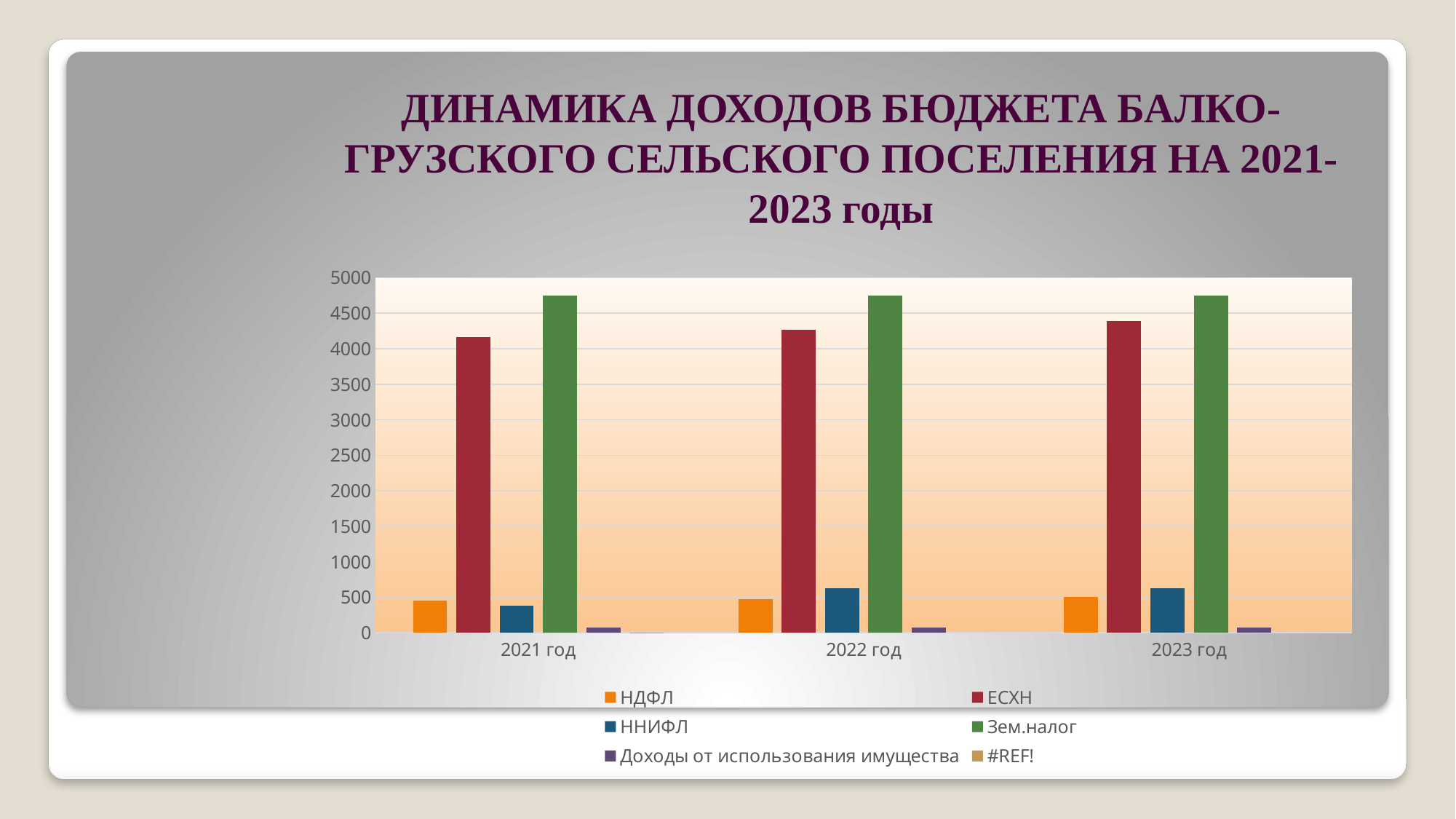
What colour are the bars for Зем.налог? green Which is larger in 2021 год: ЕСХН or Зем.налог? Зем.налог Is the value for ННИФЛ in 2022 год greater or less than 500? greater Which is larger in 2022 год: НДФЛ or ННИФЛ? ННИФЛ How many series does the legend list? 6 Do the values for ЕСХН rise or fall from 2021 год to 2023 год? rise Is the value for ЕСХН in 2021 год greater or less than 4000? greater Is the value for Зем.налог in 2023 год greater or less than 5000? less How many year categories are shown on the x axis? 3 Which of the labelled series has the lowest bar in 2022 год? Доходы от использования имущества Which series has the highest bar in 2021 год? Зем.налог What kind of chart is shown on the slide? bar chart